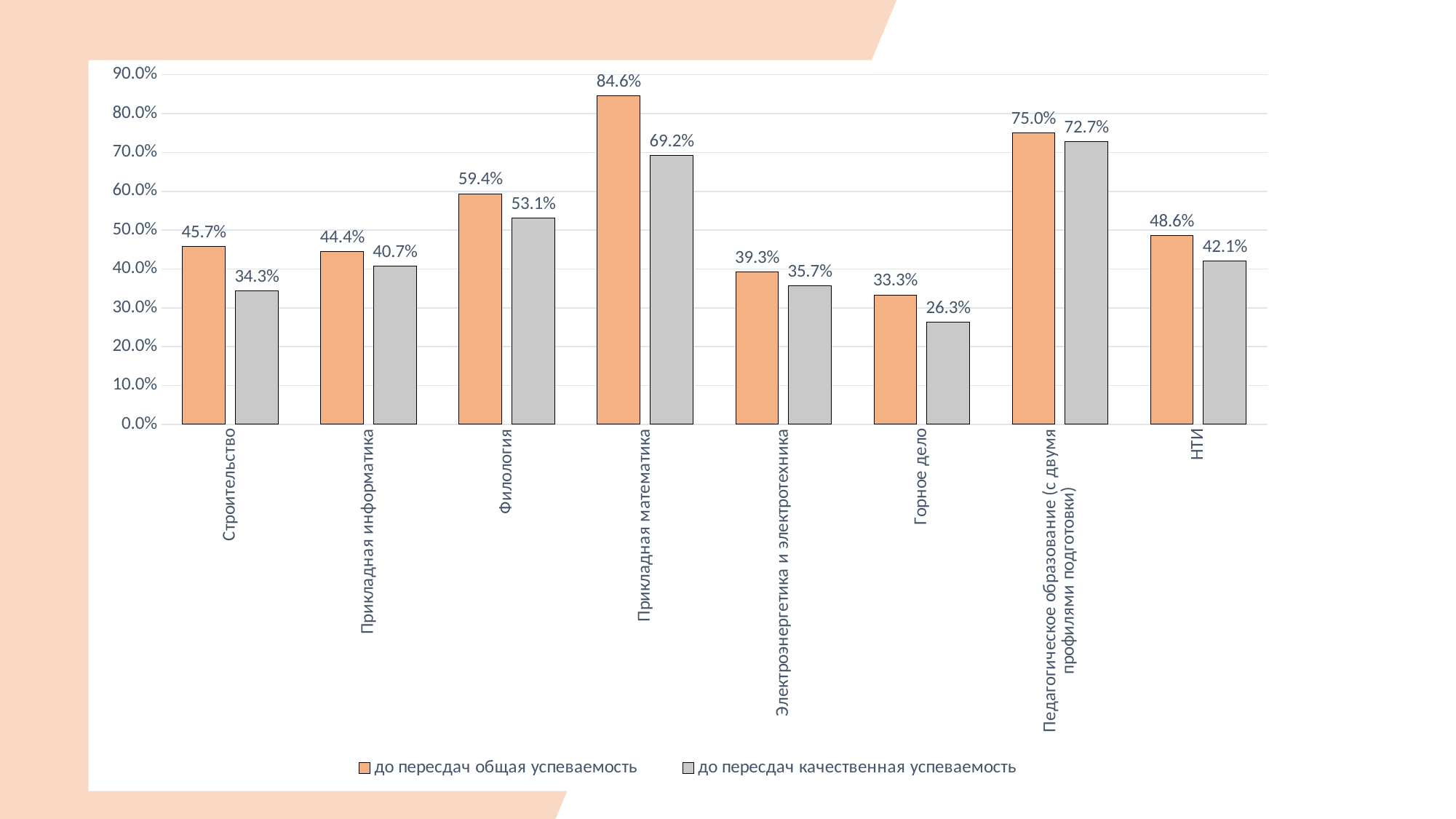
Which category has the highest value for 'до пересдач общая успеваемость'? Прикладная математика What kind of chart is shown on the slide? bar chart What is the value of 'до пересдач общая успеваемость' for Прикладная математика? 84.6% What colour are the bars for 'до пересдач качественная успеваемость'? grey Is the value of 'до пересдач общая успеваемость' for Педагогическое образование (с двумя профилями подготовки) greater or less than 70.0%? greater How many series does the legend list? 2 Which category has the lowest value for 'до пересдач качественная успеваемость'? Горное дело What is the value of 'до пересдач качественная успеваемость' for Горное дело? 26.3% Which is larger for Филология: 'до пересдач общая успеваемость' or 'до пересдач качественная успеваемость'? до пересдач общая успеваемость How many categories are shown on the x axis? 8 What is the value of 'до пересдач качественная успеваемость' for НТИ? 42.1% What is the difference between 'до пересдач общая успеваемость' and 'до пересдач качественная успеваемость' for Строительство? 11.4%